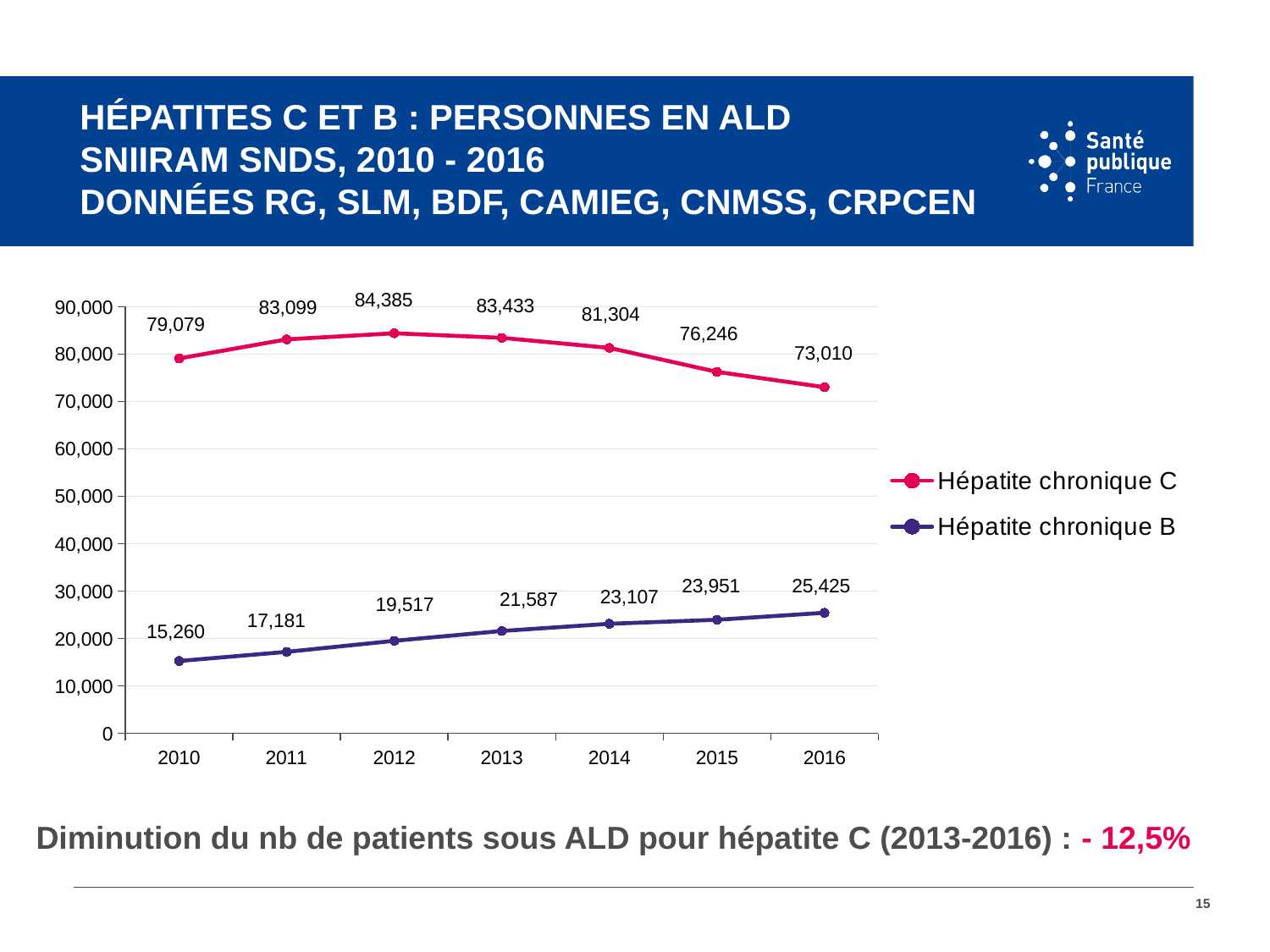
Which is larger in 2014: Hépatite chronique C or Hépatite chronique B? Hépatite chronique C What kind of chart is shown on the slide? Line chart How many series does the legend list? 2 What is the value for Hépatite chronique B in 2010? 15,260 What is the value for Hépatite chronique C in 2012? 84,385 How many years are shown on the x axis? 7 In which year is the Hépatite chronique C series highest? 2012 What is the difference between the Hépatite chronique C values in 2013 and 2016? 10,423 What is the value for Hépatite chronique C in 2016? 73,010 Does the Hépatite chronique B series rise or fall from 2010 to 2016? Rise What colour is the line for Hépatite chronique C? Red (pink) In which year is the Hépatite chronique B series lowest? 2010